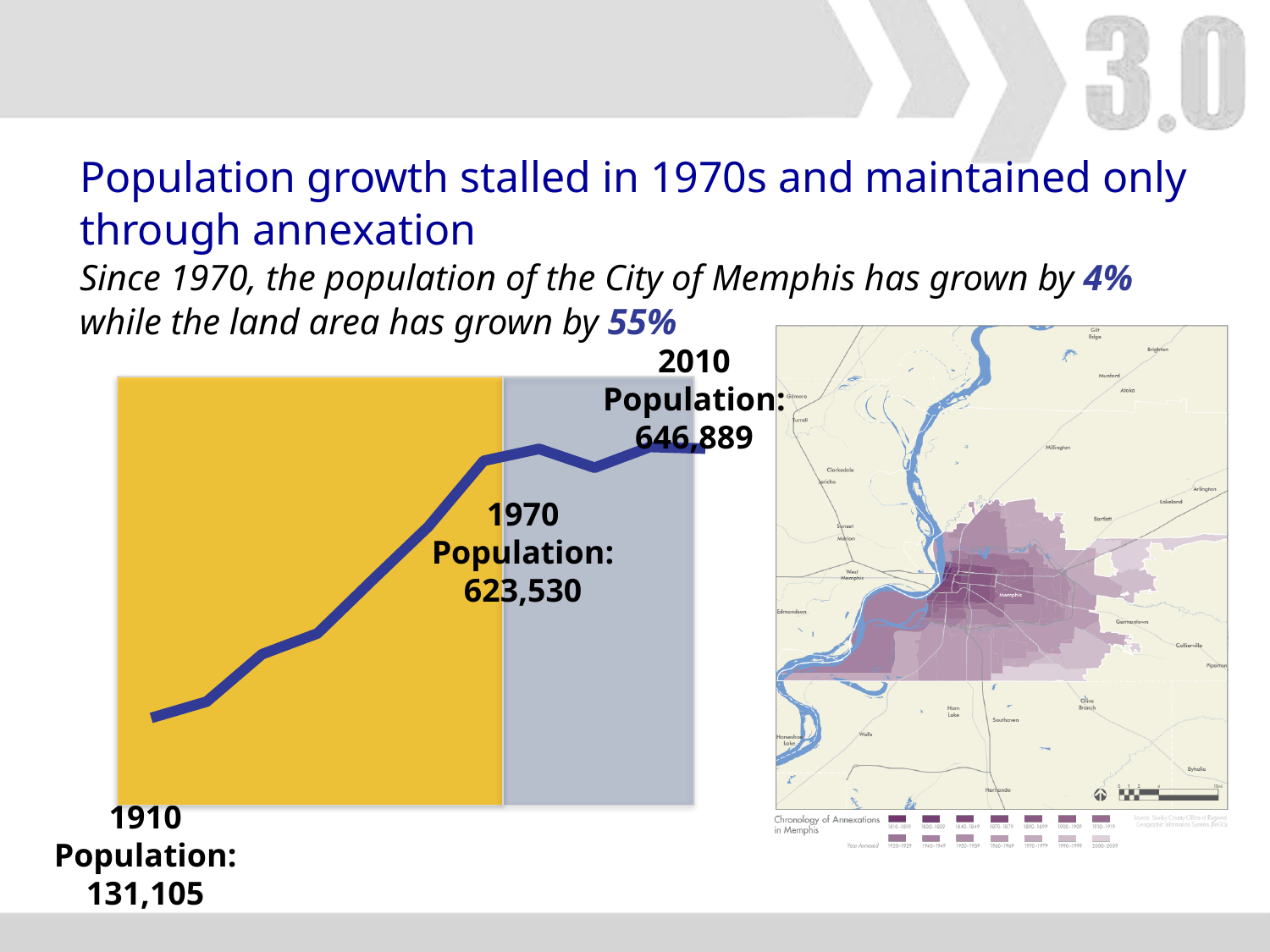
According to the slide text, by what percentage has the land area of Memphis grown since 1970? 55% What was the population of Memphis in 2010 according to the chart? 646,889 What was the population of Memphis in 1910 according to the chart? 131,105 Which is larger, the 1970 population or the 2010 population? 2010 population By how much did the population grow between 1910 and 1970 according to the labeled values? 492,425 What was the population of Memphis in 1970 according to the chart? 623,530 Which labeled year on the chart has the highest population? 2010 Which labeled year on the chart has the lowest population? 1910 Does the population line generally rise or fall from 1910 to 1970? rise By how much did the population grow between 1970 and 2010 according to the labeled values? 23,359 According to the slide text, by what percentage has the population of Memphis grown since 1970? 4% What kind of chart is shown on the left of the slide? line chart